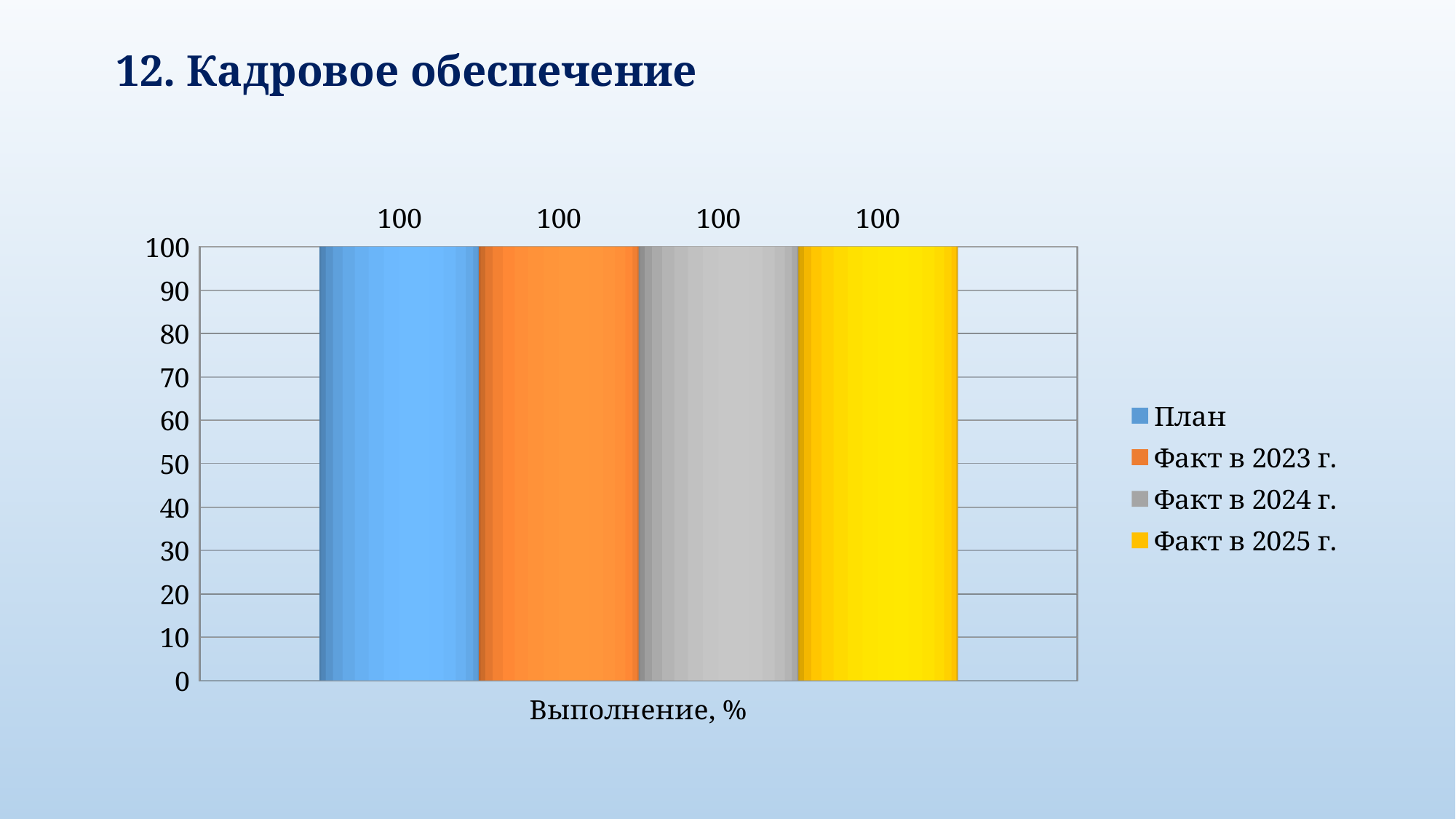
Which colour represents the Факт в 2024 г. series in the legend? grey What is the value of Факт в 2025 г. for Выполнение, %? 100 What kind of chart is shown on the slide? bar chart What is the value of the План series for Выполнение, %? 100 What is the maximum value shown on the vertical axis? 100 What is the difference between the План value and the Факт в 2025 г. value? 0 What is the value of Факт в 2024 г. for Выполнение, %? 100 How many series does the legend list? 4 What is the x-axis category label of the chart? Выполнение, % How many categories are shown on the x axis? 1 What is the value of Факт в 2023 г. for Выполнение, %? 100